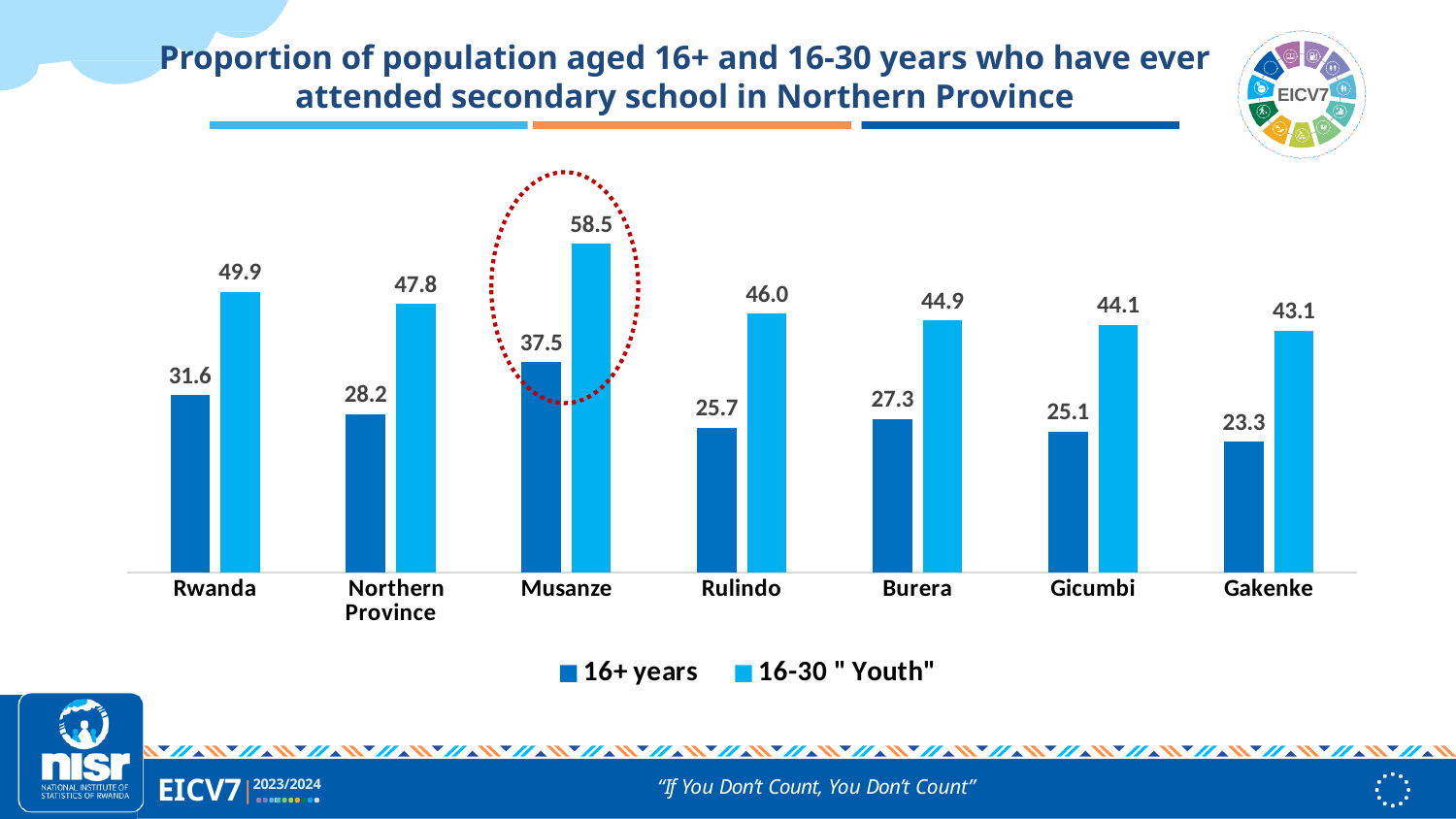
What kind of chart is shown on the slide? Bar chart How many categories are shown on the x axis? 7 Which category has the highest value for 16-30 "Youth"? Musanze What is the difference between the 16-30 "Youth" and 16+ years values for Rwanda? 18.3 What is the difference between the 16-30 "Youth" values for Musanze and Rulindo? 12.5 How many series does the legend list? 2 Which is larger: the 16+ years value for Burera or for Gicumbi? Burera What is the value for 16-30 "Youth" in Gakenke? 43.1 What is the value for 16+ years in Northern Province? 28.2 Which category has the lowest value for 16+ years? Gakenke Which category is highlighted with a red dotted circle? Musanze What is the value for 16+ years in Musanze? 37.5